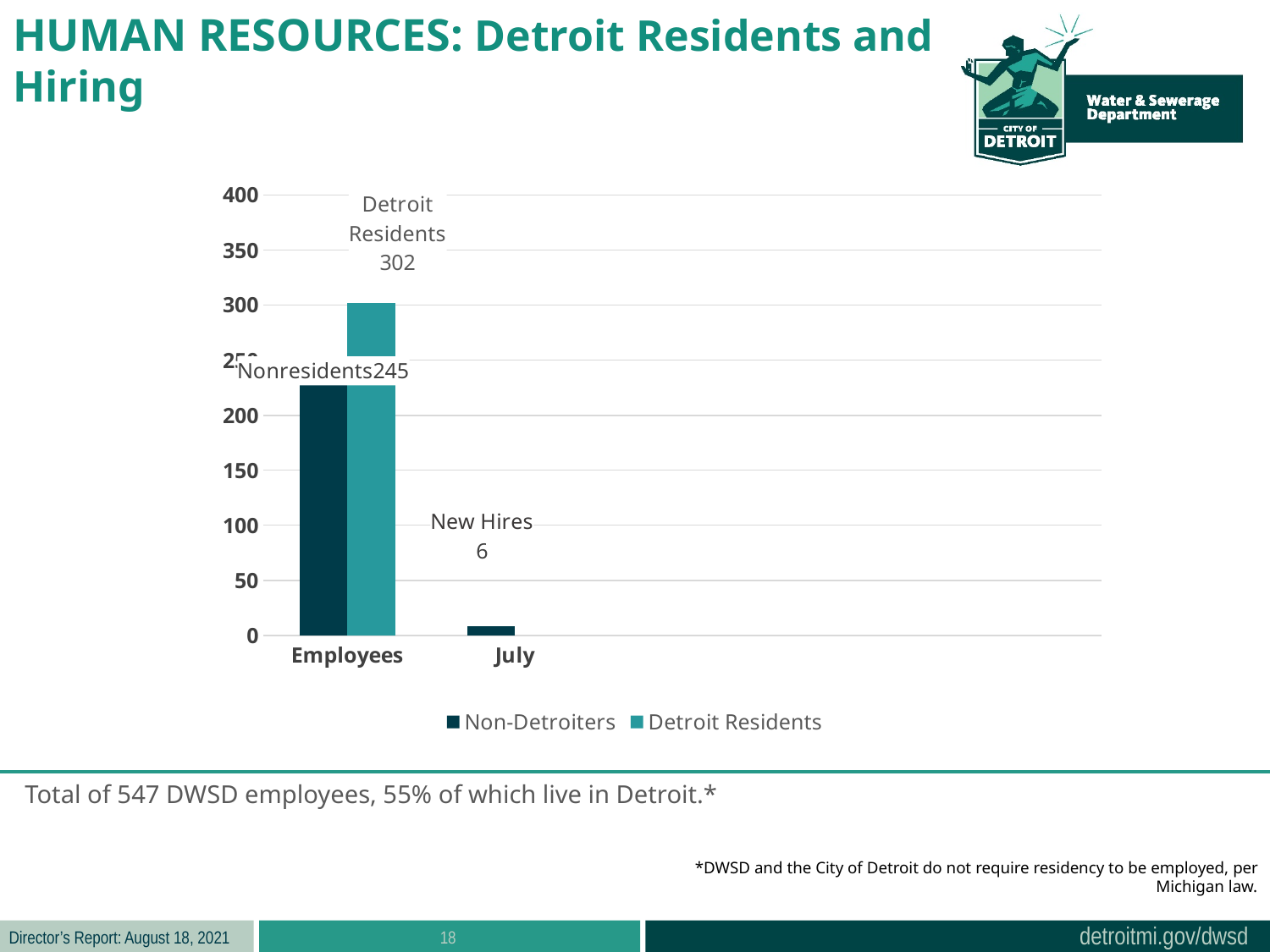
What is the value labelled New Hires in the July category? 6 Is the value for Detroit Residents in the Employees category greater or less than 300? greater What is the value for Nonresidents in the Employees category? 245 What are the two series named in the legend? Non-Detroiters and Detroit Residents In the Employees category, which is larger: Detroit Residents or Nonresidents? Detroit Residents How many categories are shown on the x axis? 2 Is the value for Nonresidents in the Employees category greater or less than 250? less What kind of chart is shown on the slide? bar chart What is the value for Detroit Residents in the Employees category? 302 What is the difference between Detroit Residents (302) and Nonresidents (245) in the Employees category? 57 Which category has the lowest bar on the chart? July How many series does the legend list? 2